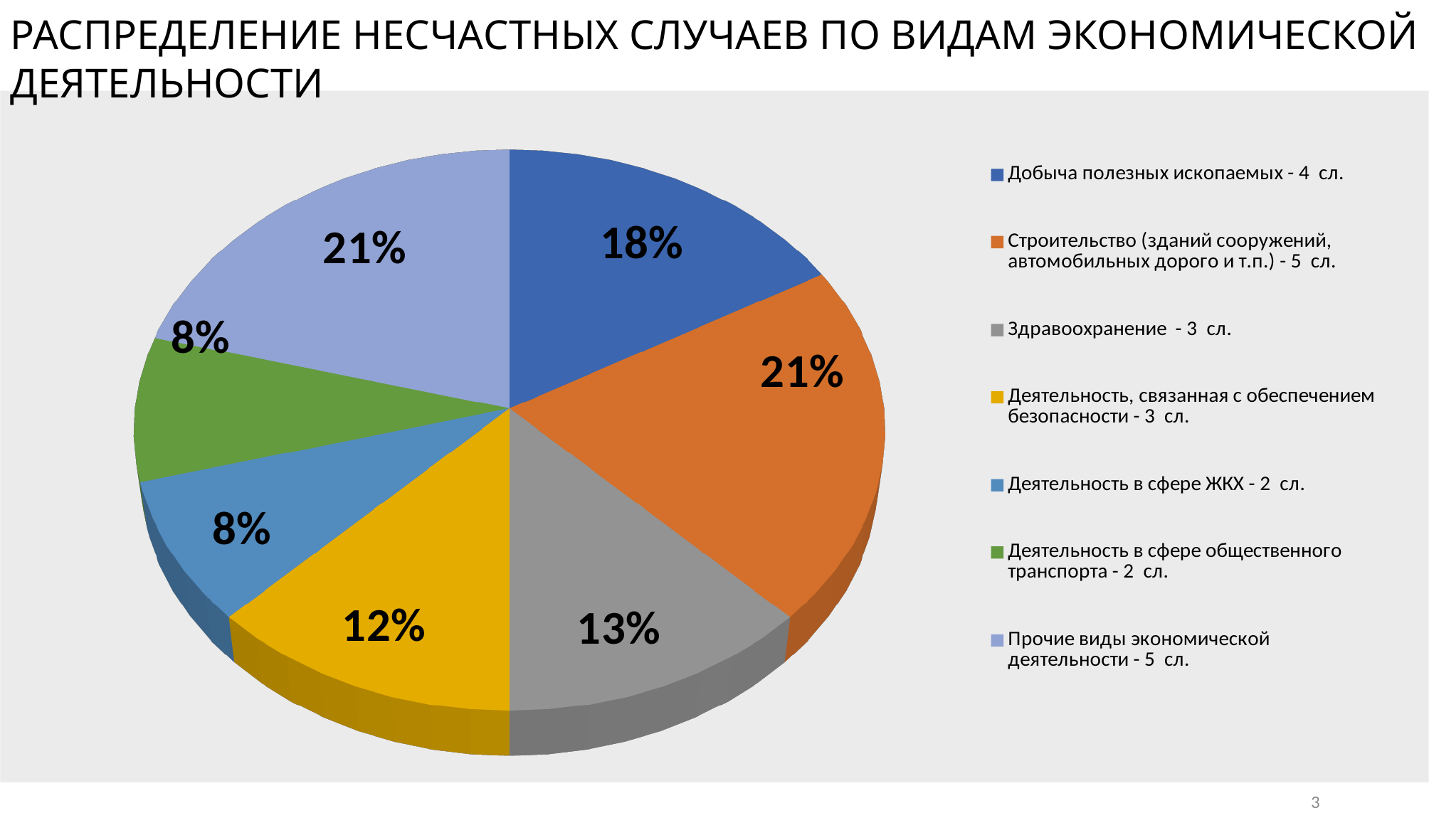
According to the legend, how many cases (сл.) are attributed to "Добыча полезных ископаемых"? 4 What share of the pie does "Деятельность в сфере ЖКХ" have? 8% What share of the pie does "Деятельность, связанная с обеспечением безопасности" have? 12% What share of the pie does "Строительство (зданий сооружений, автомобильных дорого и т.п.)" have? 21% What share of the pie does "Здравоохранение" have? 13% Which is larger: the share for "Добыча полезных ископаемых" or the share for "Здравоохранение"? Добыча полезных ископаемых How many slices does the pie chart have? 7 What share of the pie does "Добыча полезных ископаемых" have? 18% What kind of chart is shown on the slide? Pie chart What colour is the slice for "Деятельность в сфере общественного транспорта"? Green What is the difference in percentage points between the share for "Строительство" and the share for "Добыча полезных ископаемых"? 3 What share of the pie does "Прочие виды экономической деятельности" have? 21%